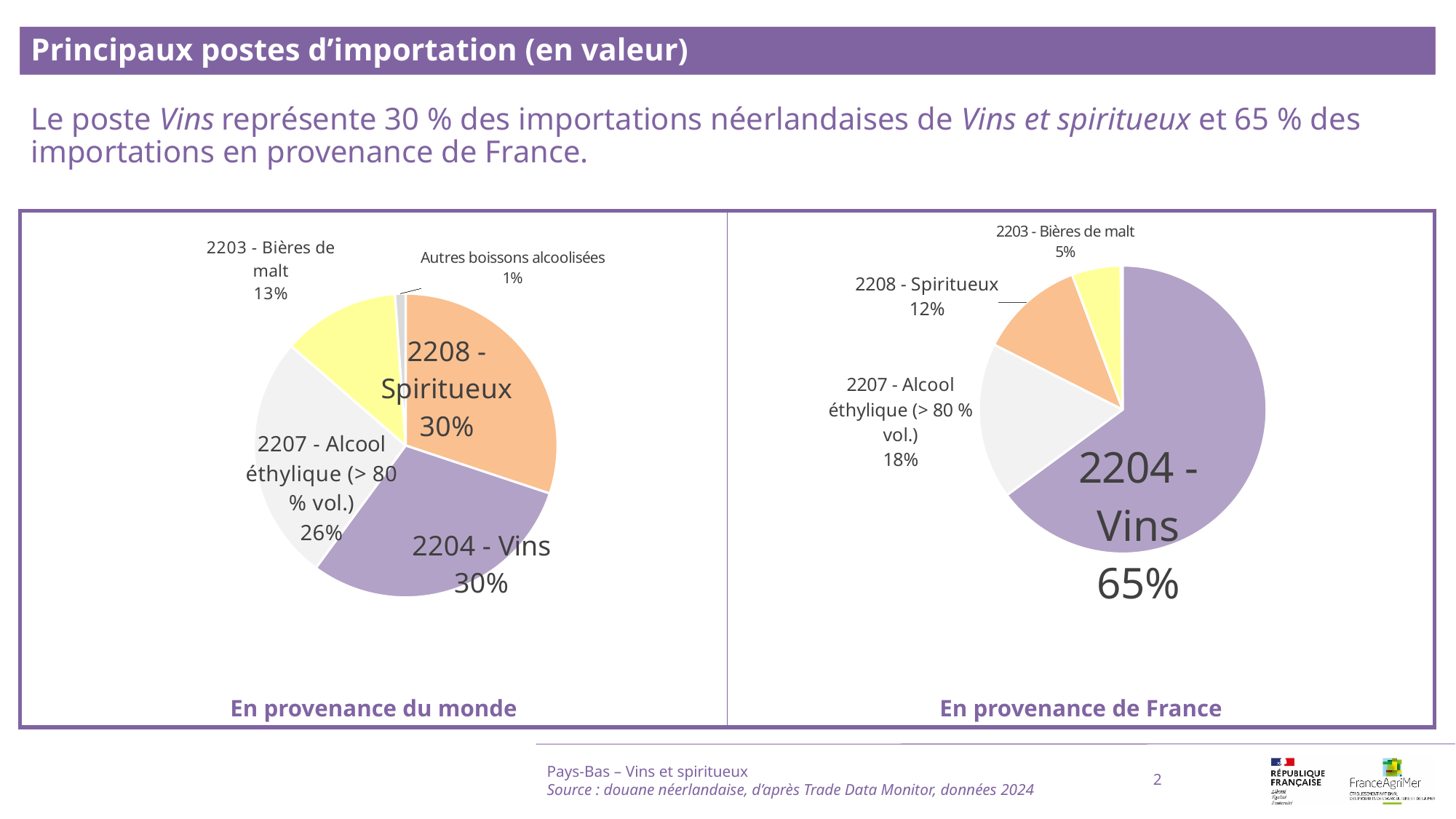
In the 'En provenance de France' chart, which is larger: 2207 - Alcool éthylique (> 80 % vol.) or 2208 - Spiritueux? 2207 - Alcool éthylique (> 80 % vol.) In the 'En provenance de France' chart, which category has the smallest slice? 2203 - Bières de malt In the 'En provenance du monde' chart, what share does 2203 - Bières de malt represent? 13% In the 'En provenance du monde' chart, what is the difference between the shares of 2204 - Vins and 2203 - Bières de malt? 17 percentage points In the 'En provenance du monde' chart, how many slices does the pie have? 5 In the 'En provenance du monde' chart, which category has the smallest slice? Autres boissons alcoolisées In the 'En provenance de France' chart, what share does 2208 - Spiritueux represent? 12% In the 'En provenance de France' chart, what share does 2204 - Vins represent? 65% In the 'En provenance de France' chart, which category has the largest slice? 2204 - Vins What type of chart is used on this slide? Pie chart In the 'En provenance de France' chart, how many slices does the pie have? 4